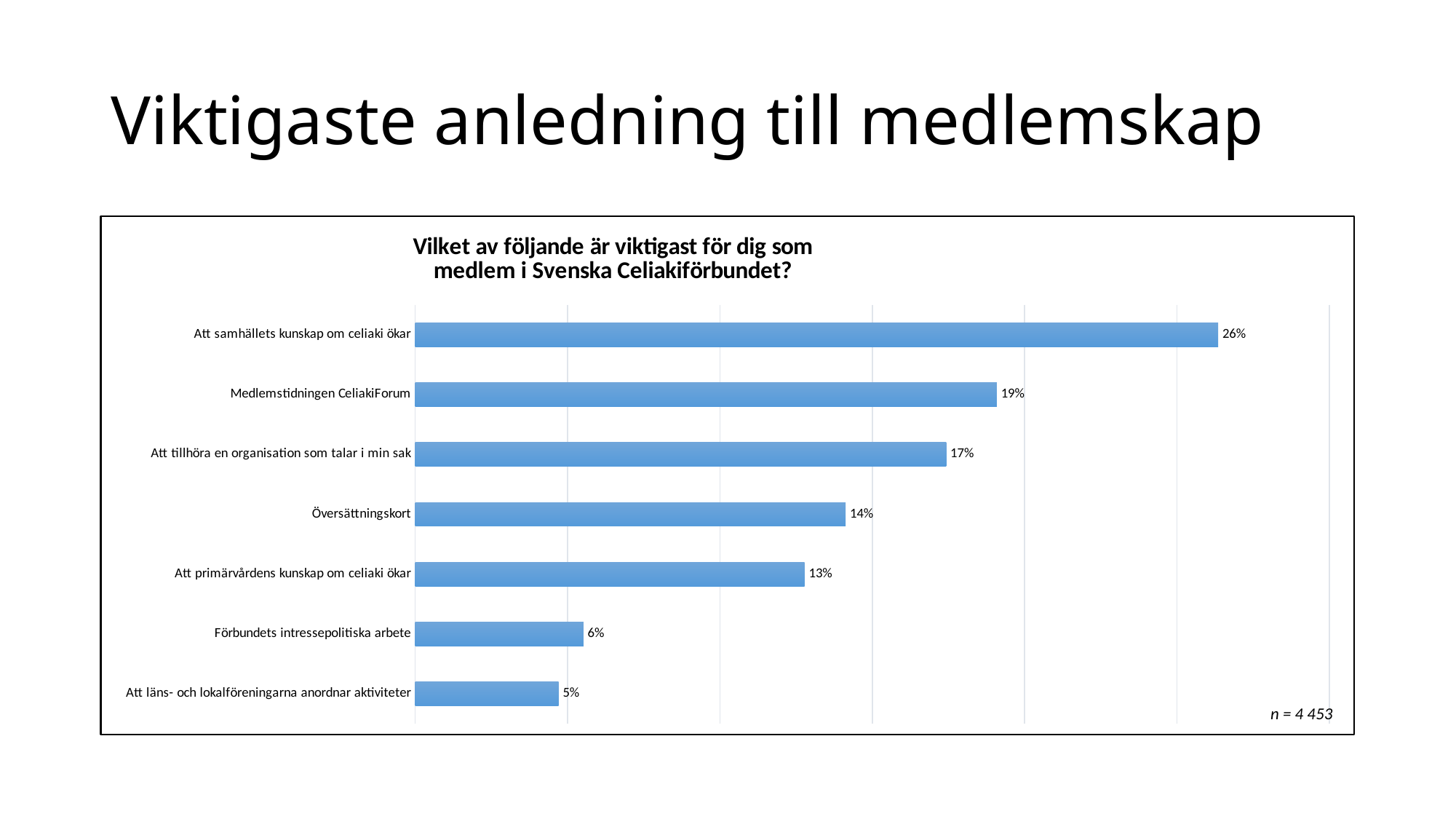
Which category has the highest value? Att samhällets kunskap om celiaki ökar What is the value for "Att läns- och lokalföreningarna anordnar aktiviteter"? 5% Which category has the lowest value? Att läns- och lokalföreningarna anordnar aktiviteter What is the difference between the values for "Att samhällets kunskap om celiaki ökar" and "Medlemstidningen CeliakiForum"? 7% What kind of chart is shown on the slide? Bar chart What is the difference between the values for "Förbundets intressepolitiska arbete" and "Att läns- och lokalföreningarna anordnar aktiviteter"? 1% What is the value for "Att samhällets kunskap om celiaki ökar"? 26% Which is larger: the value for "Att tillhöra en organisation som talar i min sak" or the value for "Att primärvårdens kunskap om celiaki ökar"? Att tillhöra en organisation som talar i min sak What sample size (n) is shown on the chart? n = 4 453 What is the value for "Medlemstidningen CeliakiForum"? 19% How many categories are shown in the chart? 7 What is the value for "Översättningskort"? 14%